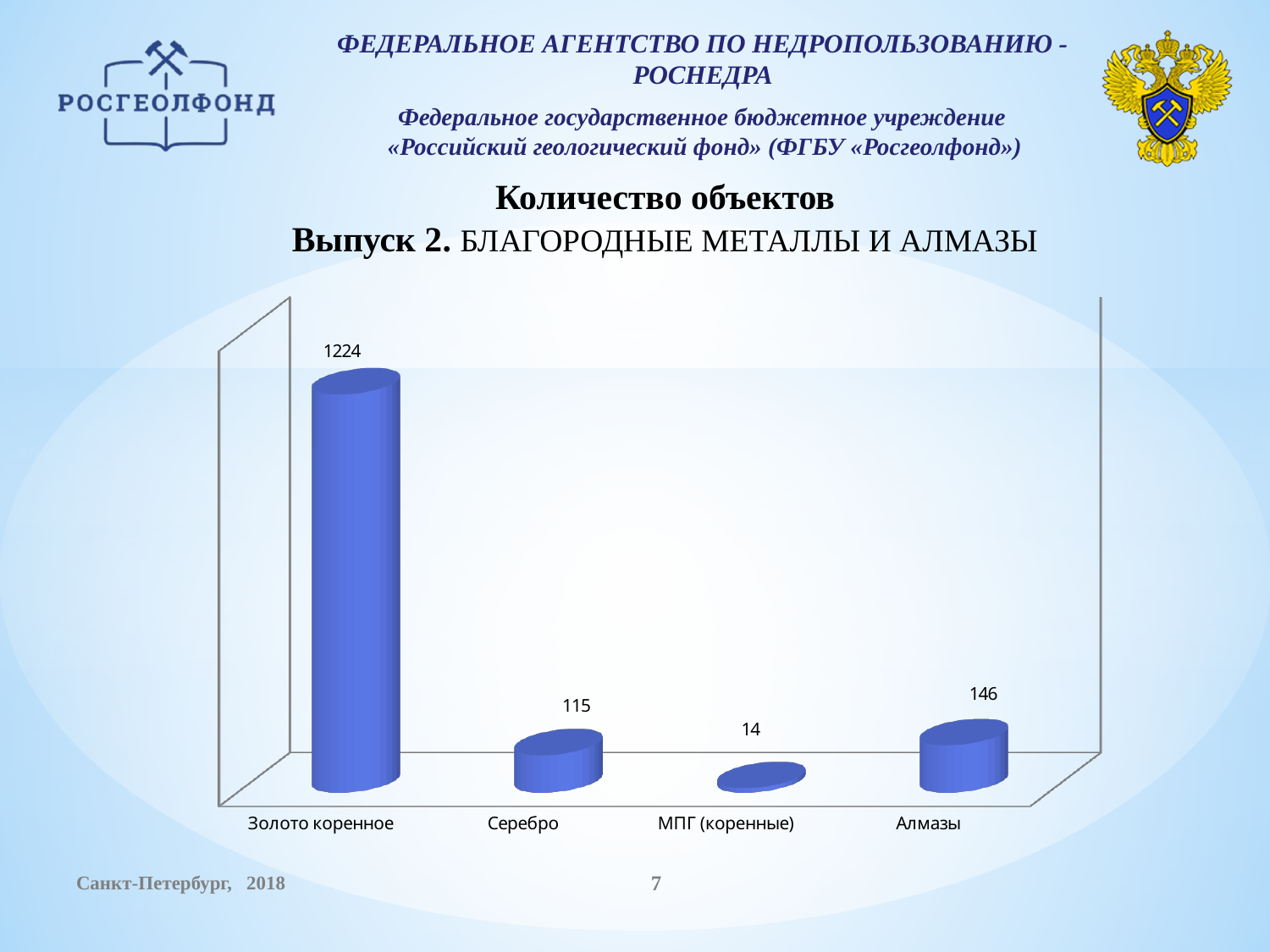
What kind of chart is shown on the slide? bar chart Which category has the lowest value? МПГ (коренные) What is the difference between the values for Алмазы and Серебро? 31 Which category has the highest value? Золото коренное Which is larger, the value for Серебро or the value for Алмазы? Алмазы What is the value for МПГ (коренные)? 14 What is the title of the chart? Количество объектов Выпуск 2. БЛАГОРОДНЫЕ МЕТАЛЛЫ И АЛМАЗЫ What is the value for Серебро? 115 What is the value for Золото коренное? 1224 What is the value for Алмазы? 146 What is the difference between the values for Золото коренное and Алмазы? 1078 How many categories are shown in the chart? 4